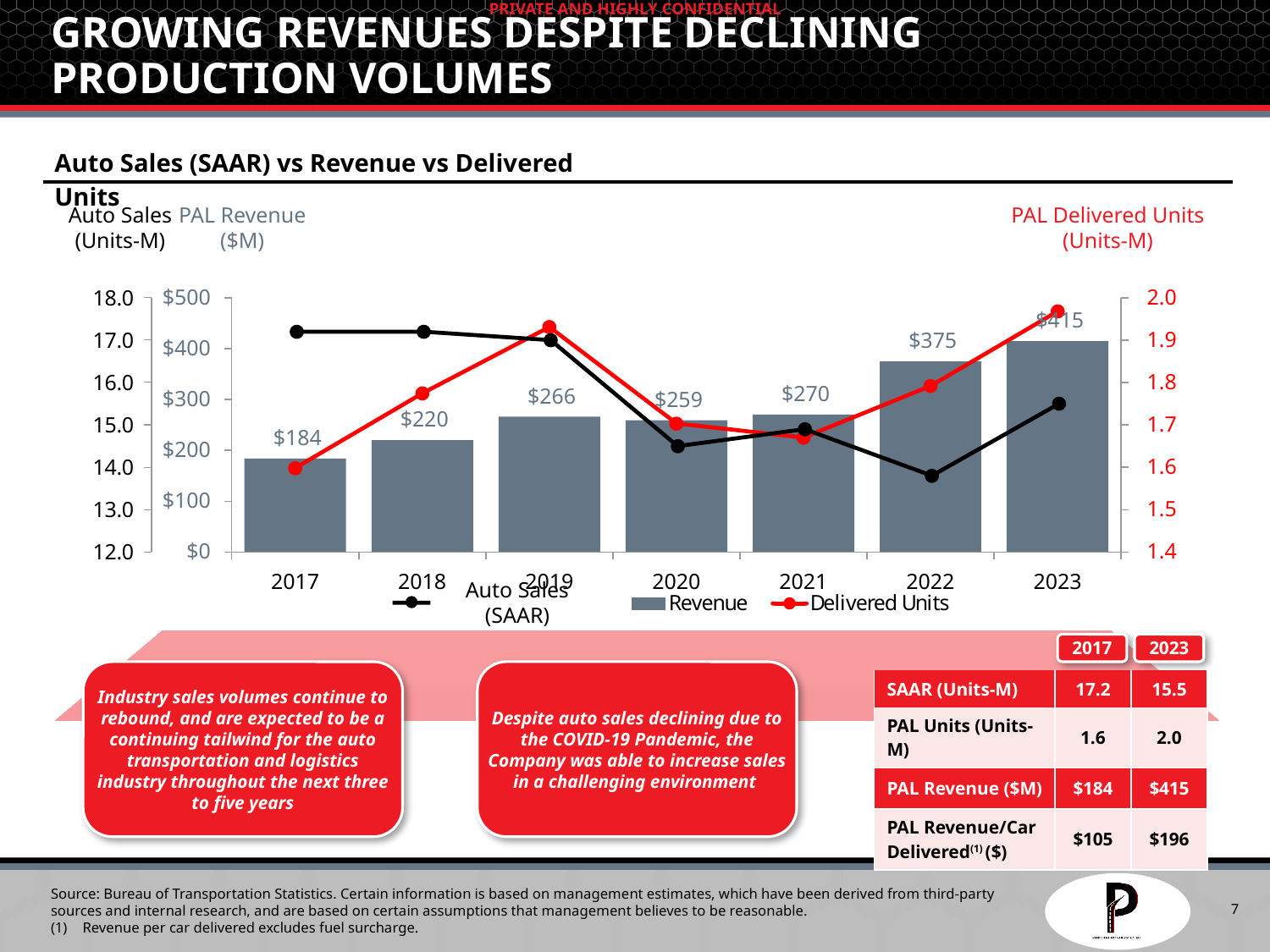
What kind of chart is shown on the slide? Combined bar and line chart Which year has higher PAL Revenue, 2019 or 2020? 2019 How many years are shown on the x axis of the chart? 7 Which year has the highest PAL Revenue? 2023 What is the PAL Revenue value for 2017? $184 Which year has the lowest PAL Revenue? 2017 How many series does the chart legend list? 3 Is the Delivered Units value for 2023 greater or less than 1.9? greater What is the PAL Revenue value for 2022? $375 Is the Auto Sales (SAAR) value for 2022 greater or less than 15.0? less What is the difference in PAL Revenue between 2023 and 2017? $231 What is the PAL Revenue value for 2020? $259